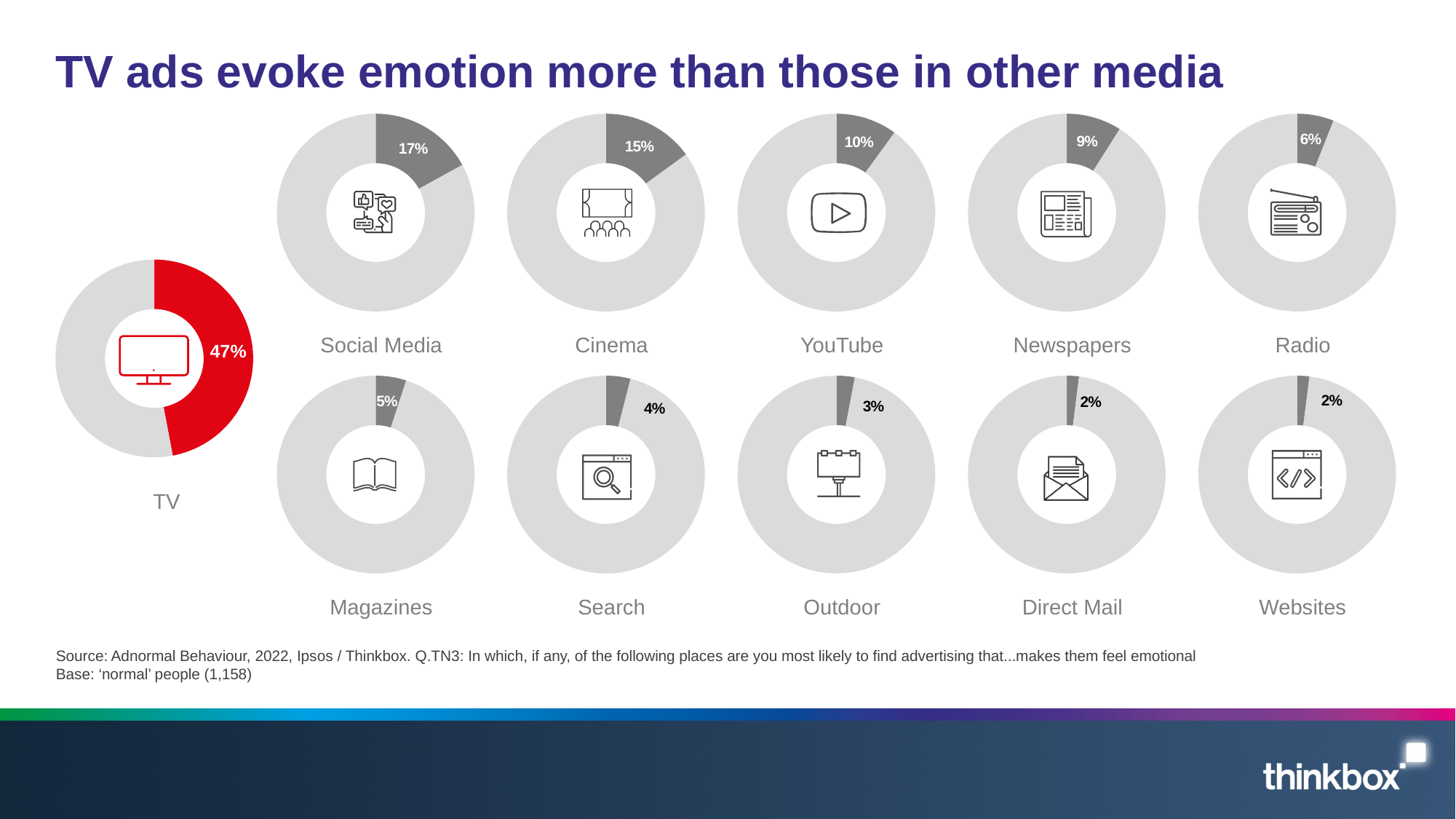
What percentage is shown for TV? 47% What percentage is shown for Newspapers? 9% How many media categories are shown on the slide? 11 What kind of chart is used for each medium on the slide? Donut chart What percentage is shown for Social Media? 17% Which has a higher percentage, Cinema or Newspapers? Cinema What is the difference between the TV percentage and the Social Media percentage? 30% Which has a higher percentage, Radio or Magazines? Radio What is the difference between the Cinema percentage and the YouTube percentage? 5% What percentage is shown for Outdoor? 3% Which medium has the highest percentage on the slide? TV Which two media share the lowest percentage of 2%? Direct Mail and Websites